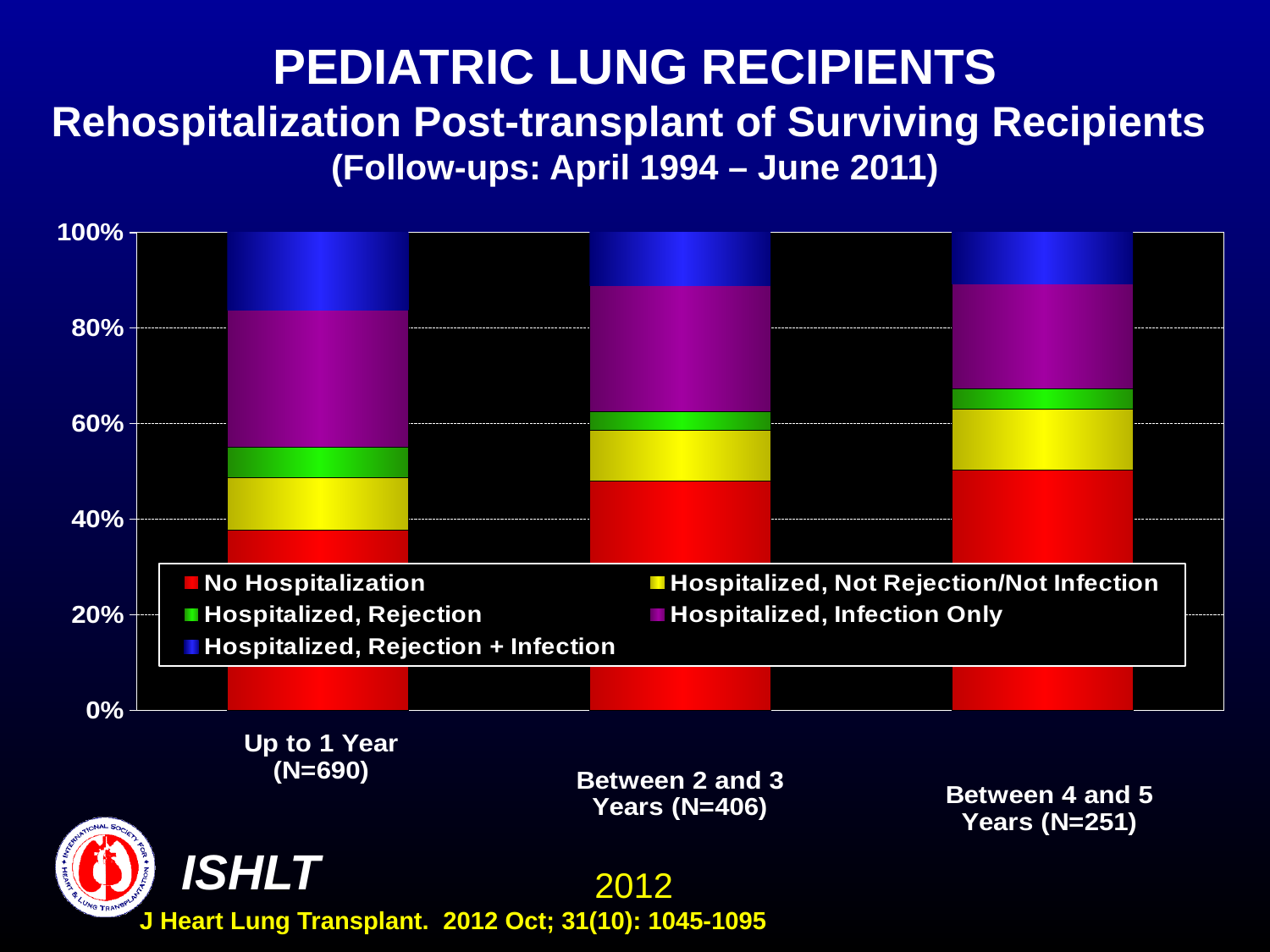
Which follow-up category has the largest Hospitalized, Rejection + Infection share? Up to 1 Year Is the No Hospitalization share for Up to 1 Year greater or less than 40%? less Does the No Hospitalization share rise or fall moving from Up to 1 Year to Between 4 and 5 Years? rise Is the No Hospitalization share for Between 2 and 3 Years greater or less than 40%? greater Is the No Hospitalization share larger for Up to 1 Year or for Between 4 and 5 Years? Between 4 and 5 Years Which follow-up category has the smallest No Hospitalization share? Up to 1 Year Is the No Hospitalization share for Between 4 and 5 Years greater or less than 40%? greater What is the N for the Up to 1 Year category? N=690 How many follow-up time categories are plotted on the x axis? 3 What colour represents Hospitalized, Infection Only in the legend? Purple What kind of chart is shown on the slide? Stacked bar chart How many series does the legend list? 5